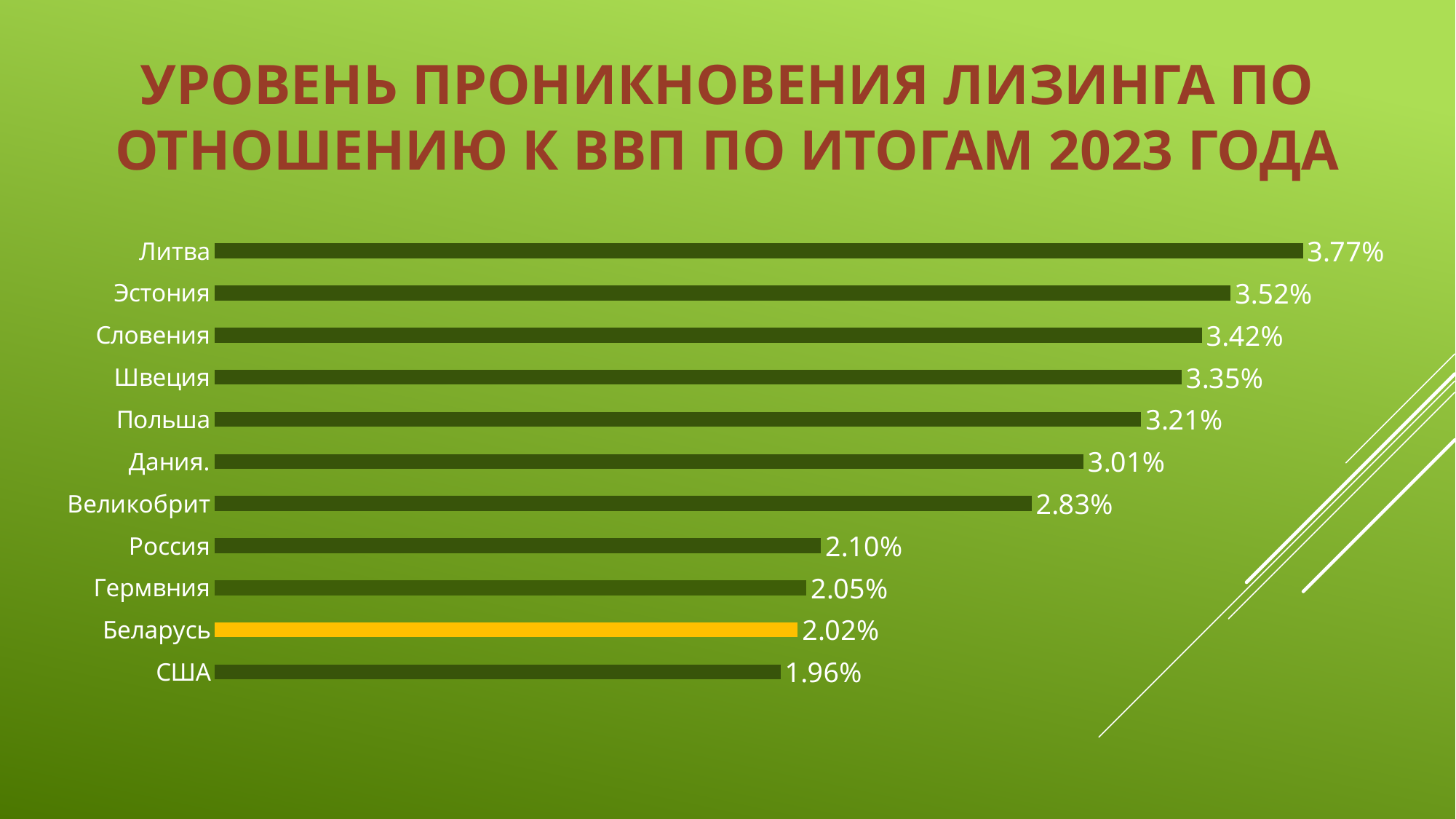
How many countries are shown in the chart? 11 What is the value for Литва? 3.77% Which is larger, the value for Швеция or the value for Дания.? Швеция What kind of chart is shown on the slide? bar chart What is the difference between the values for Литва and Эстония? 0.25% What is the value for Великобрит? 2.83% What is the value for Беларусь? 2.02% Which country has the lowest value? США What is the difference between the values for Беларусь and США? 0.06% Which country's bar is highlighted in a different colour (yellow)? Беларусь Which country has the highest value? Литва What is the value for Польша? 3.21%